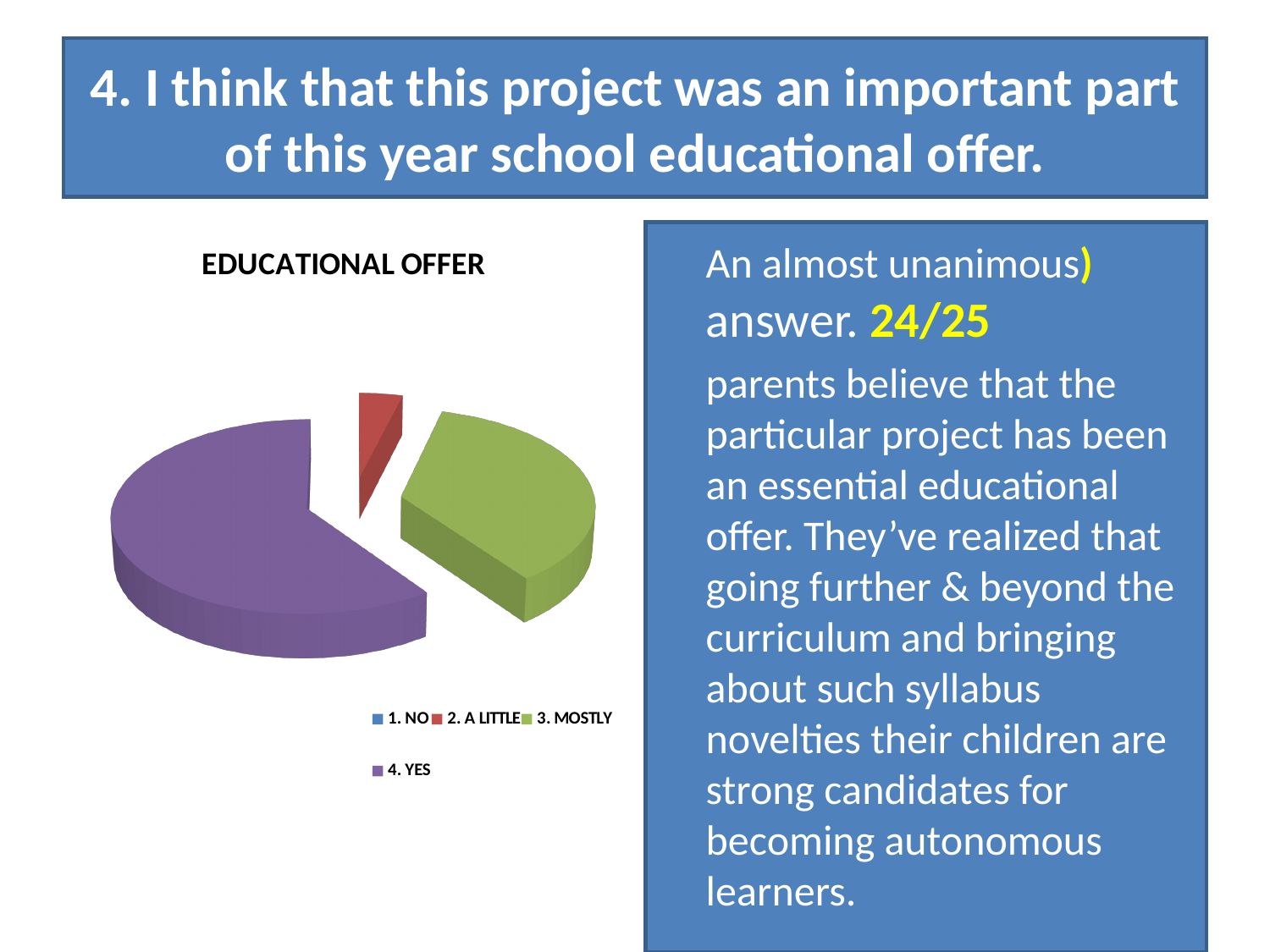
Which category has the largest slice of the pie? 4. YES What is the title of the chart? EDUCATIONAL OFFER How many categories does the chart's legend list? 4 Which slice is larger, 4. YES or 3. MOSTLY? 4. YES What kind of chart is shown on the slide? pie chart Which slice is larger, 3. MOSTLY or 2. A LITTLE? 3. MOSTLY Does the slice for 4. YES take up more or less than half of the pie? more Which slice is smaller, 2. A LITTLE or 4. YES? 2. A LITTLE What colour is the slice for 4. YES? purple